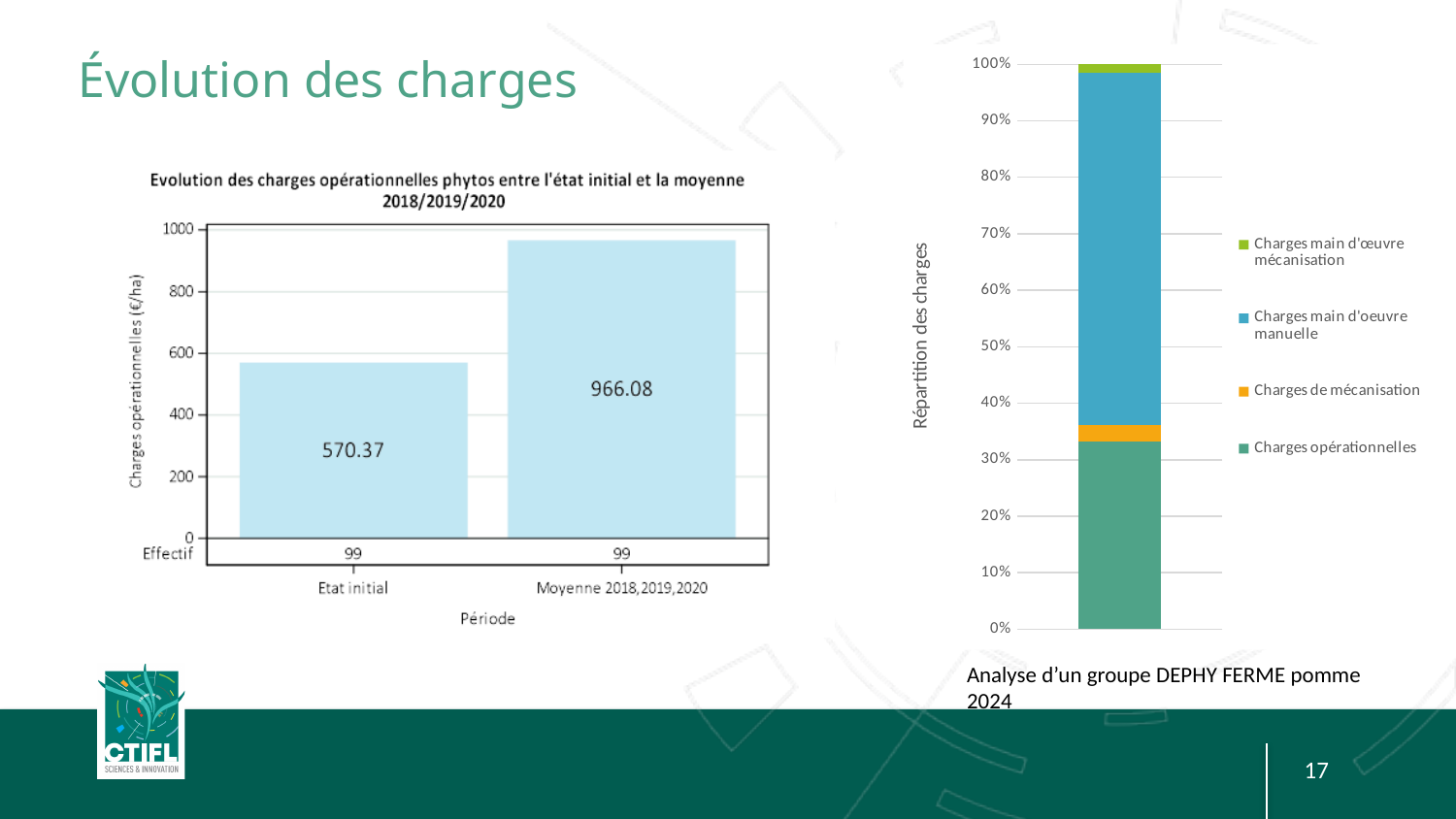
In the left chart, what is the value for Moyenne 2018,2019,2020? 966.08 What kind of chart is the left chart? bar chart In the left chart, which period has the lower operational charges? Etat initial In the left chart, what is the value for Etat initial? 570.37 In the right chart, is the share of Charges opérationnelles greater or less than 40%? less In the left chart, which period has the higher operational charges? Moyenne 2018,2019,2020 In the left chart, what is the difference between the Moyenne 2018,2019,2020 value and the Etat initial value? 395.71 In the left chart, what is the Effectif shown for each period? 99 In the left chart, is the value for Etat initial greater or less than 600? less In the right chart, how many series does the legend list? 4 In the left chart, how many bars are plotted? 2 In the right chart, which series occupies the largest share of the stacked bar? Charges main d'oeuvre manuelle